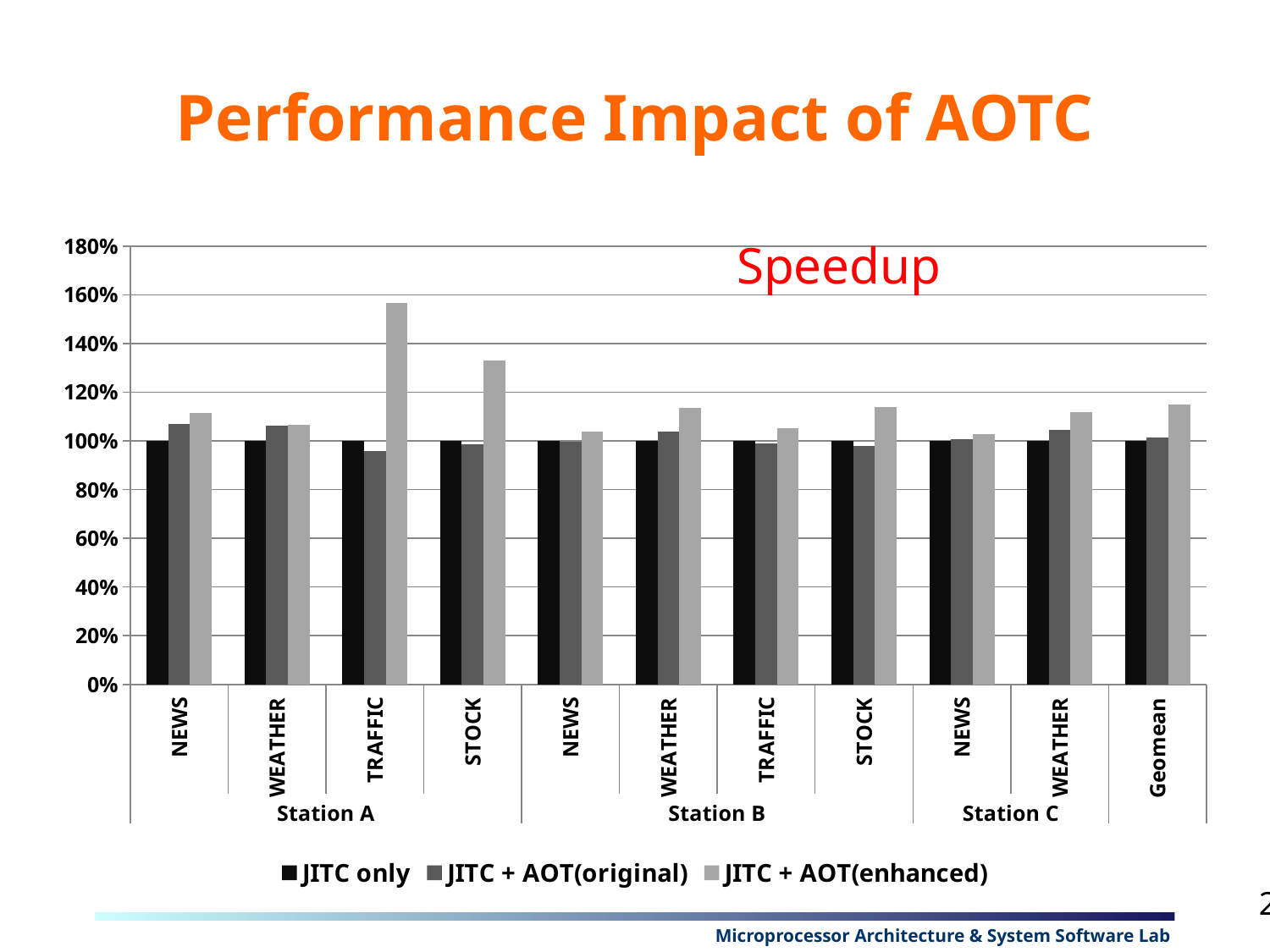
What is the value of JITC only for NEWS in Station A? 100% What kind of chart is shown on the slide? bar chart How many series does the legend list? 3 What is the title shown inside the chart area? Speedup How many categories are shown along the x axis? 11 What is the value of JITC only for Geomean? 100% Is the JITC + AOT(enhanced) value for TRAFFIC in Station A greater or less than 140%? greater Which is larger for JITC + AOT(enhanced): STOCK in Station B or NEWS in Station B? STOCK in Station B Which category has the highest JITC + AOT(enhanced) value? TRAFFIC (Station A) Is the JITC + AOT(enhanced) value for STOCK in Station A greater or less than 120%? greater Is the JITC + AOT(original) value for TRAFFIC in Station A greater or less than 100%? less Which is larger for JITC + AOT(enhanced): TRAFFIC in Station A or STOCK in Station A? TRAFFIC in Station A